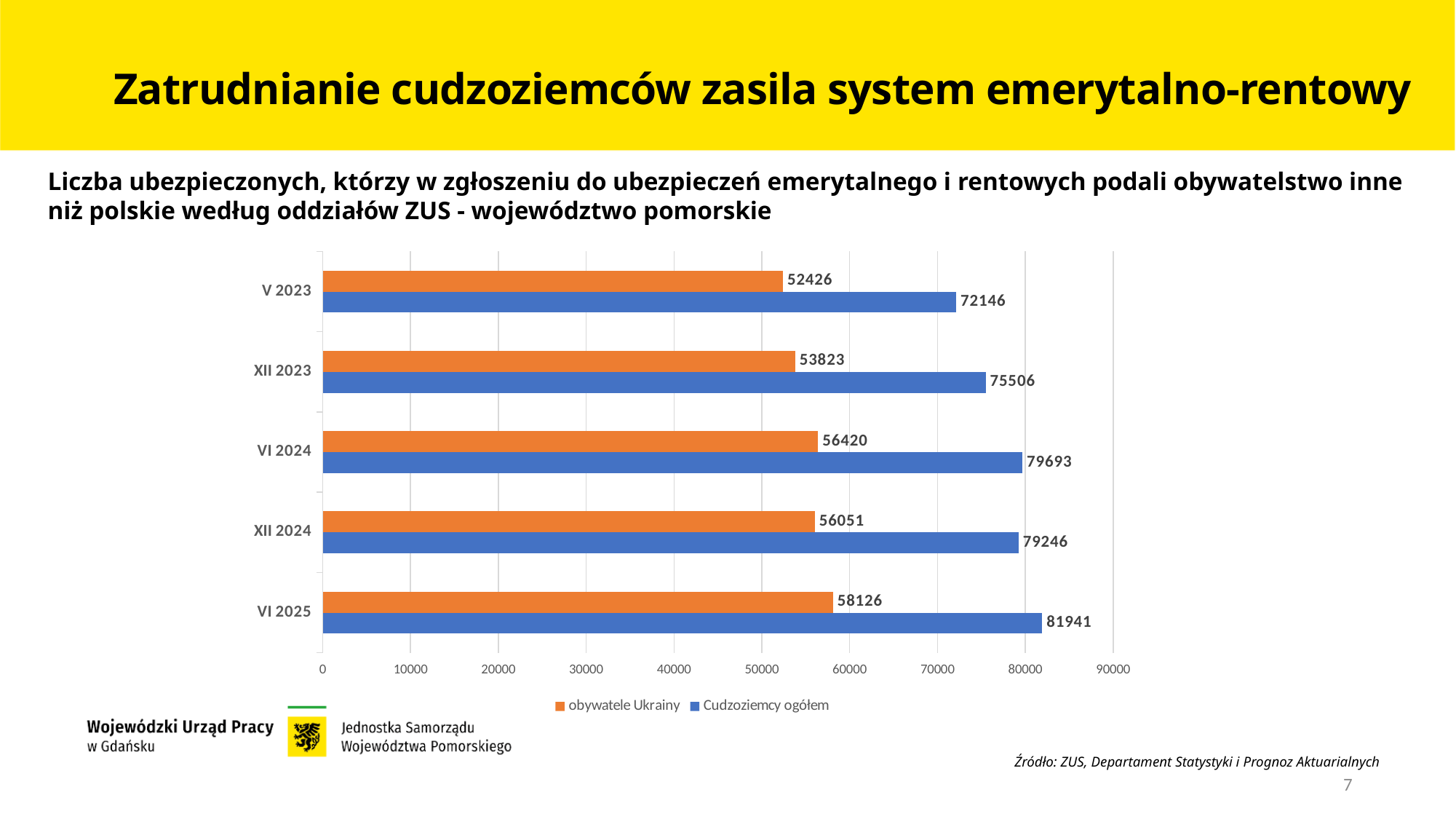
In which period is the value for Cudzoziemcy ogółem the highest? VI 2025 Which is larger for Cudzoziemcy ogółem: XII 2023 or XII 2024? XII 2024 What is the value for Cudzoziemcy ogółem in VI 2025? 81941 In which period is the value for obywatele Ukrainy the lowest? V 2023 How many series does the legend list? 2 What is the value for obywatele Ukrainy in XII 2023? 53823 What kind of chart is shown on the slide? bar chart What is the difference between Cudzoziemcy ogółem and obywatele Ukrainy in VI 2025? 23815 How many periods are shown on the chart? 5 What is the difference between Cudzoziemcy ogółem and obywatele Ukrainy in V 2023? 19720 What is the value for Cudzoziemcy ogółem in VI 2024? 79693 Is the value for Cudzoziemcy ogółem in V 2023 greater or less than 70000? greater